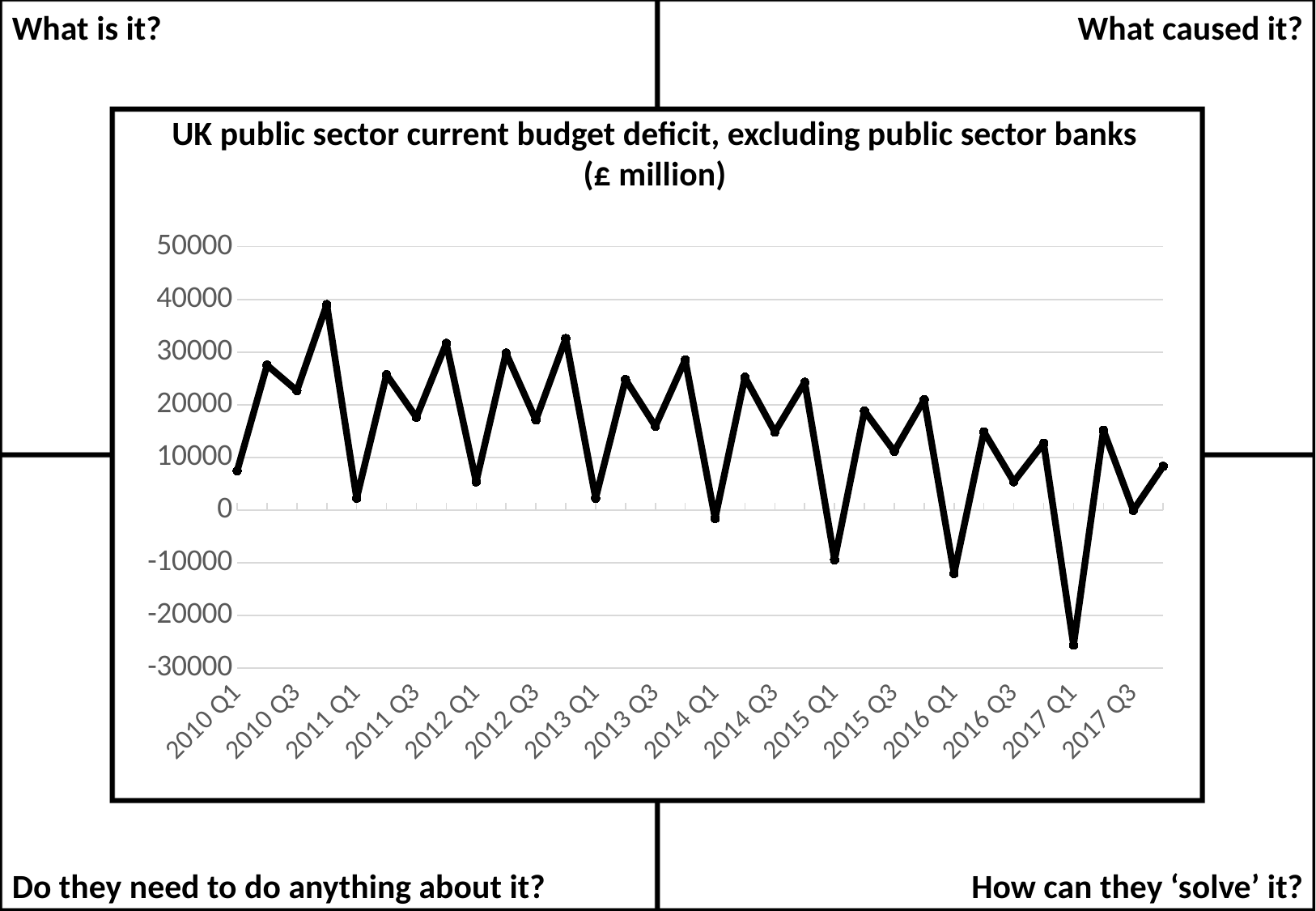
What kind of chart is shown on the slide? line chart Is the value for 2015 Q1 greater or less than 0? less In which year does the line reach its highest point? 2010 Is the value for 2013 Q1 greater or less than 10000? less Which labelled quarter has the lowest value on the chart? 2017 Q1 Is the value for 2017 Q1 greater or less than -20000? less Which is larger, the value for 2010 Q3 or the value for 2017 Q1? 2010 Q3 What is the title of the chart? UK public sector current budget deficit, excluding public sector banks (£ million) Overall, do the values rise or fall from 2010 to 2017? fall How many quarter labels are shown on the x axis? 16